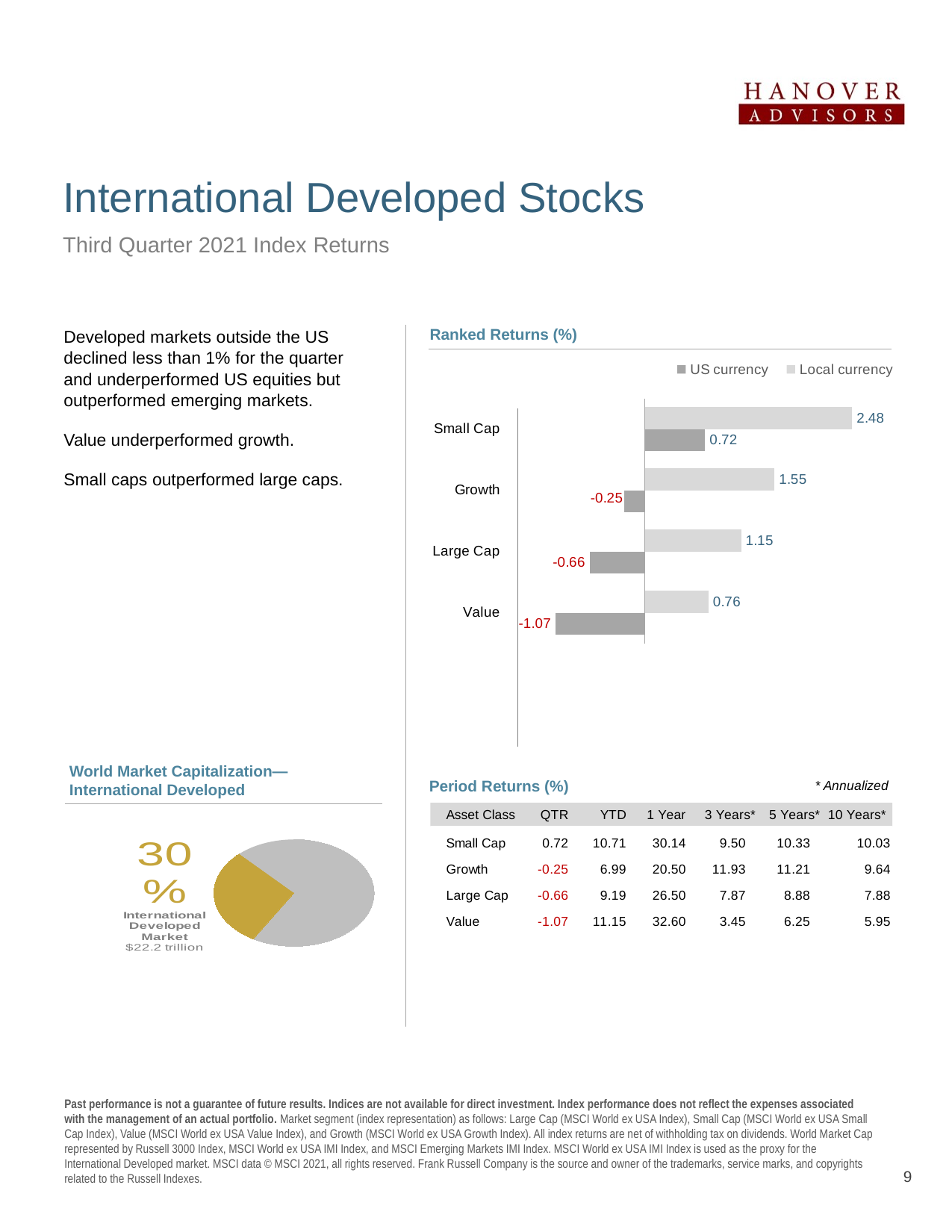
How many series does the legend of the Ranked Returns (%) chart list? 2 In the Ranked Returns (%) chart, what is the Local currency return for Growth? 1.55 In the Ranked Returns (%) chart, which category has the lowest US currency return? Value In the Ranked Returns (%) chart, what is the US currency return for Value? -1.07 In the Ranked Returns (%) chart, what is the difference between the Local currency and US currency returns for Large Cap? 1.81 In the Ranked Returns (%) chart, what is the US currency return for Small Cap? 0.72 What kind of chart is the World Market Capitalization—International Developed chart? Pie chart What kind of chart is the Ranked Returns (%) chart? Bar chart How many categories are shown in the Ranked Returns (%) chart? 4 In the Ranked Returns (%) chart, which is larger: the US currency return for Growth or the US currency return for Large Cap? Growth In the World Market Capitalization—International Developed chart, what share of the pie does the International Developed Market slice represent? 30% In the Ranked Returns (%) chart, which category has the highest Local currency return? Small Cap